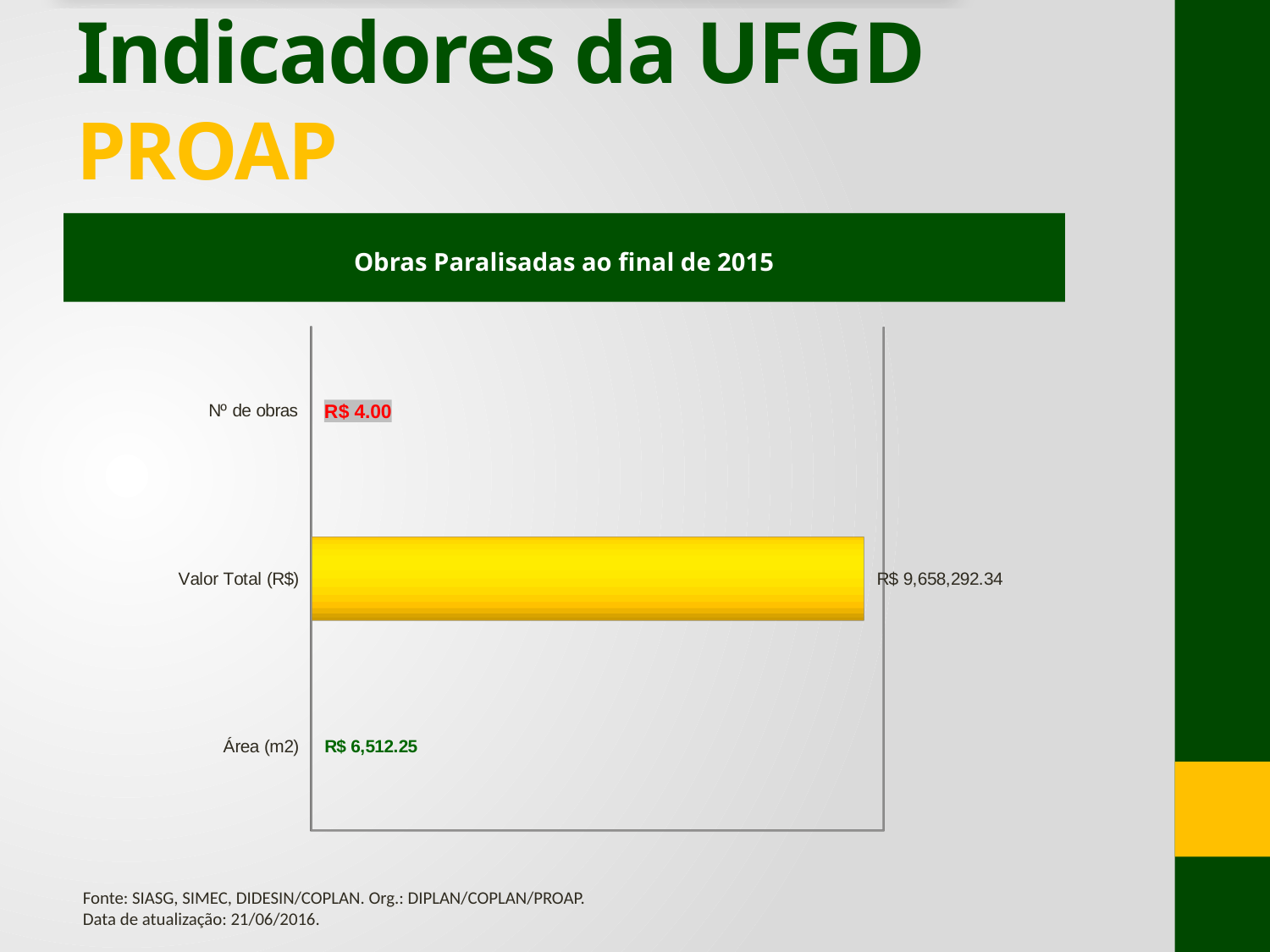
How many categories are shown in the chart? 3 What is the title of the chart? Obras Paralisadas ao final de 2015 What value is shown for Nº de obras? R$ 4.00 What value is shown for Área (m2)? R$ 6,512.25 Which category has the lowest value? Nº de obras What kind of chart is shown on the slide? Bar chart Which category has the highest value? Valor Total (R$) What is the difference between the value for Área (m2) and the value for Nº de obras? R$ 6,508.25 Which is larger, the value for Valor Total (R$) or the value for Área (m2)? Valor Total (R$) What colour is the bar for Valor Total (R$)? Yellow Which is larger, the value for Área (m2) or the value for Nº de obras? Área (m2) What value is shown for Valor Total (R$)? R$ 9,658,292.34